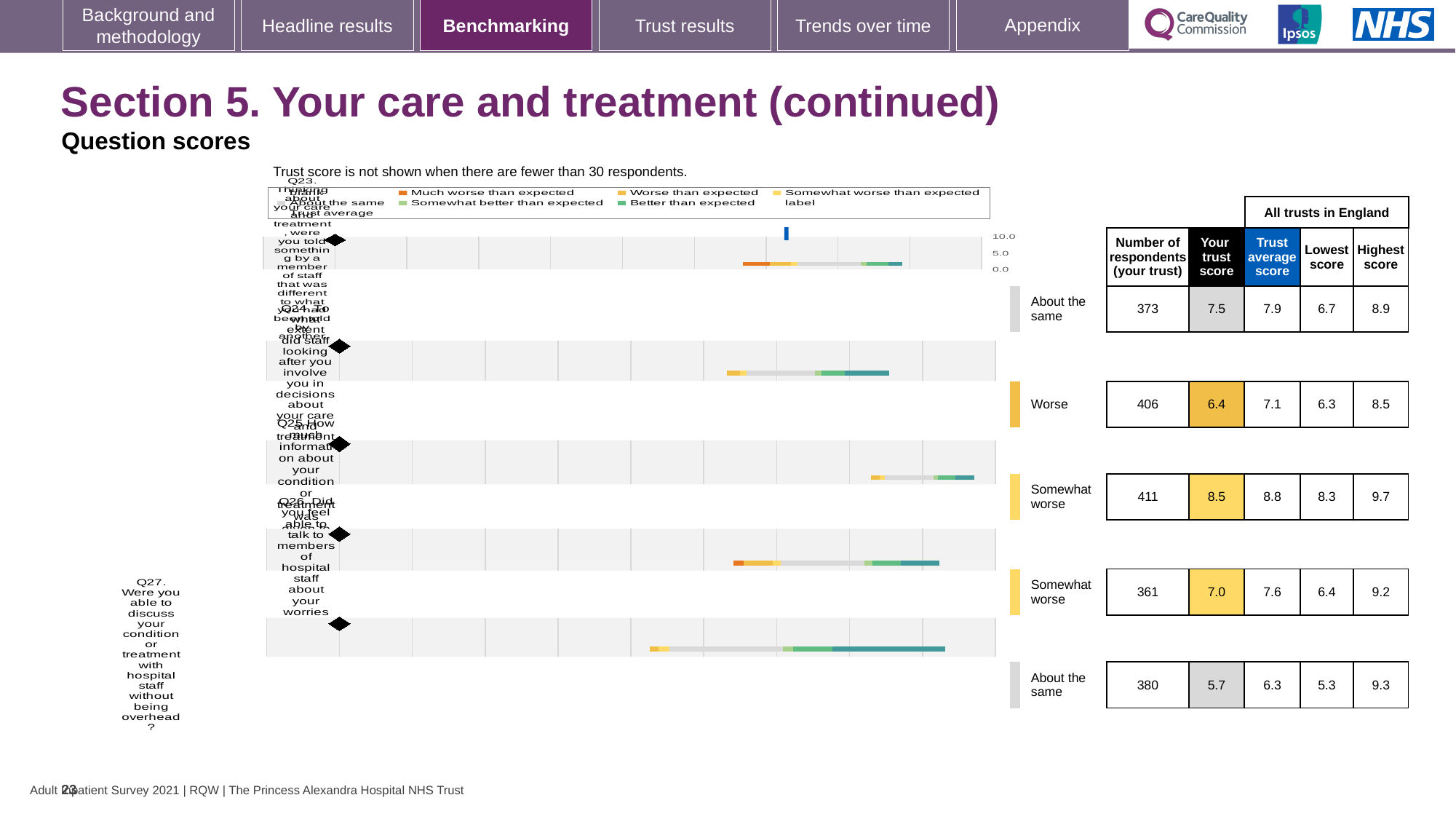
What is the highest score across all trusts in England for Q26 (feeling able to talk to hospital staff about your worries)? 9.2 How many questions are shown on the chart? 5 Which question has the lowest trust score for this trust? Q27 Is this trust's score for Q24 higher or lower than the trust average score for Q24? lower What is the lowest score across all trusts in England for Q23? 6.7 What is the difference between the trust average score and this trust's score for Q27? 0.6 Which question has the highest trust score for this trust? Q25 What is the trust score for Q27 (discussing your condition or treatment without being overheard)? 5.7 How many respondents answered Q25 (how much information about your condition or treatment was given to you) at this trust? 411 What benchmark category is shown for Q24? Worse What kind of chart is used to show the question scores? bar chart What is the trust average score for Q24 (staff involving you in decisions about your care and treatment)? 7.1